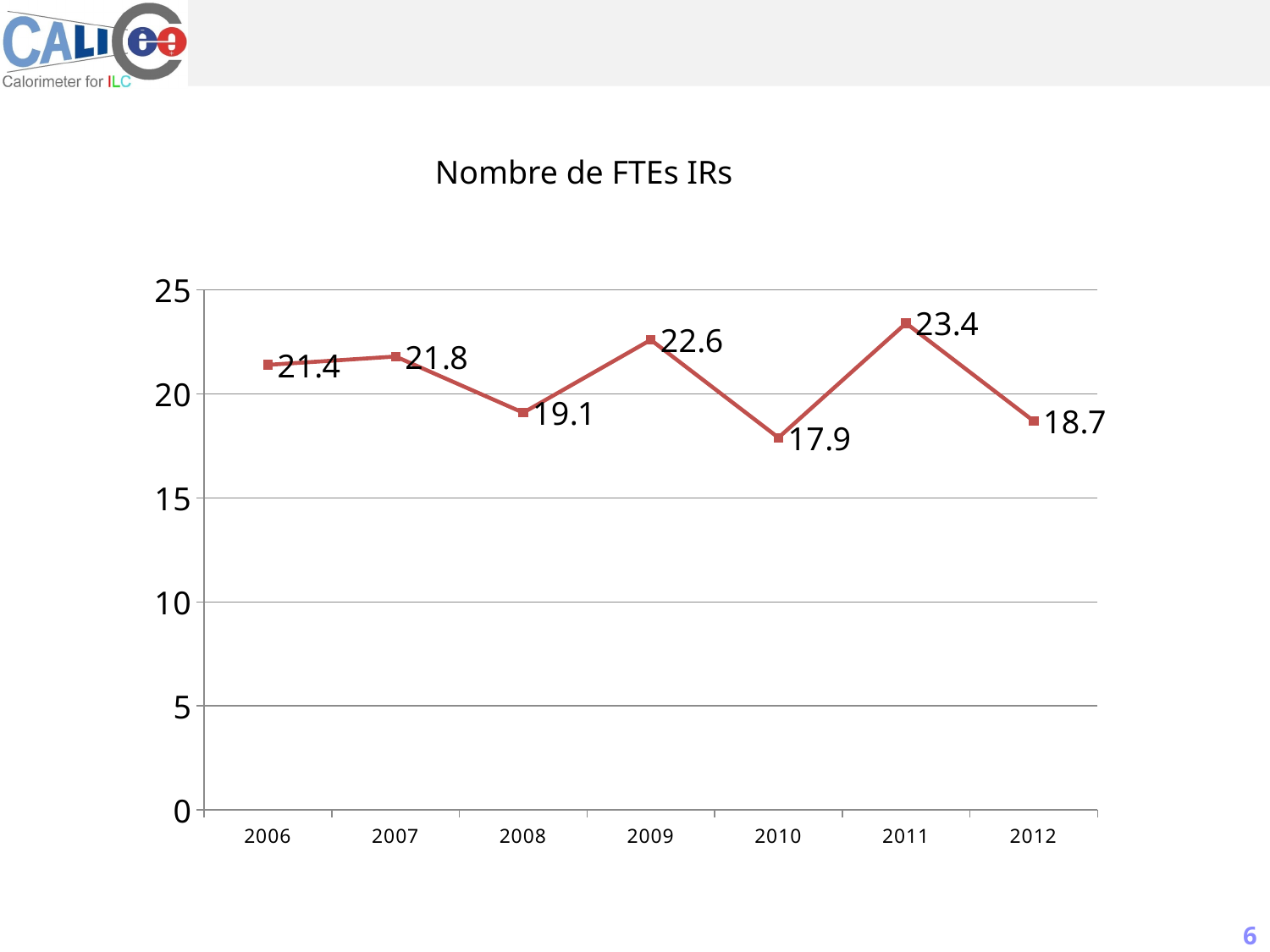
What is the value for 2010? 17.9 How many years are plotted on the chart? 7 Which year has the lowest value? 2010 What is the value for 2006? 21.4 What kind of chart is shown? line chart Which is larger, the value for 2007 or the value for 2012? 2007 Which year has the highest value? 2011 What is the title of the chart? Nombre de FTEs IRs What is the value for 2012? 18.7 What is the difference between the values for 2009 and 2008? 3.5 What is the difference between the values for 2011 and 2010? 5.5 Is the value for 2008 greater or less than 20? less